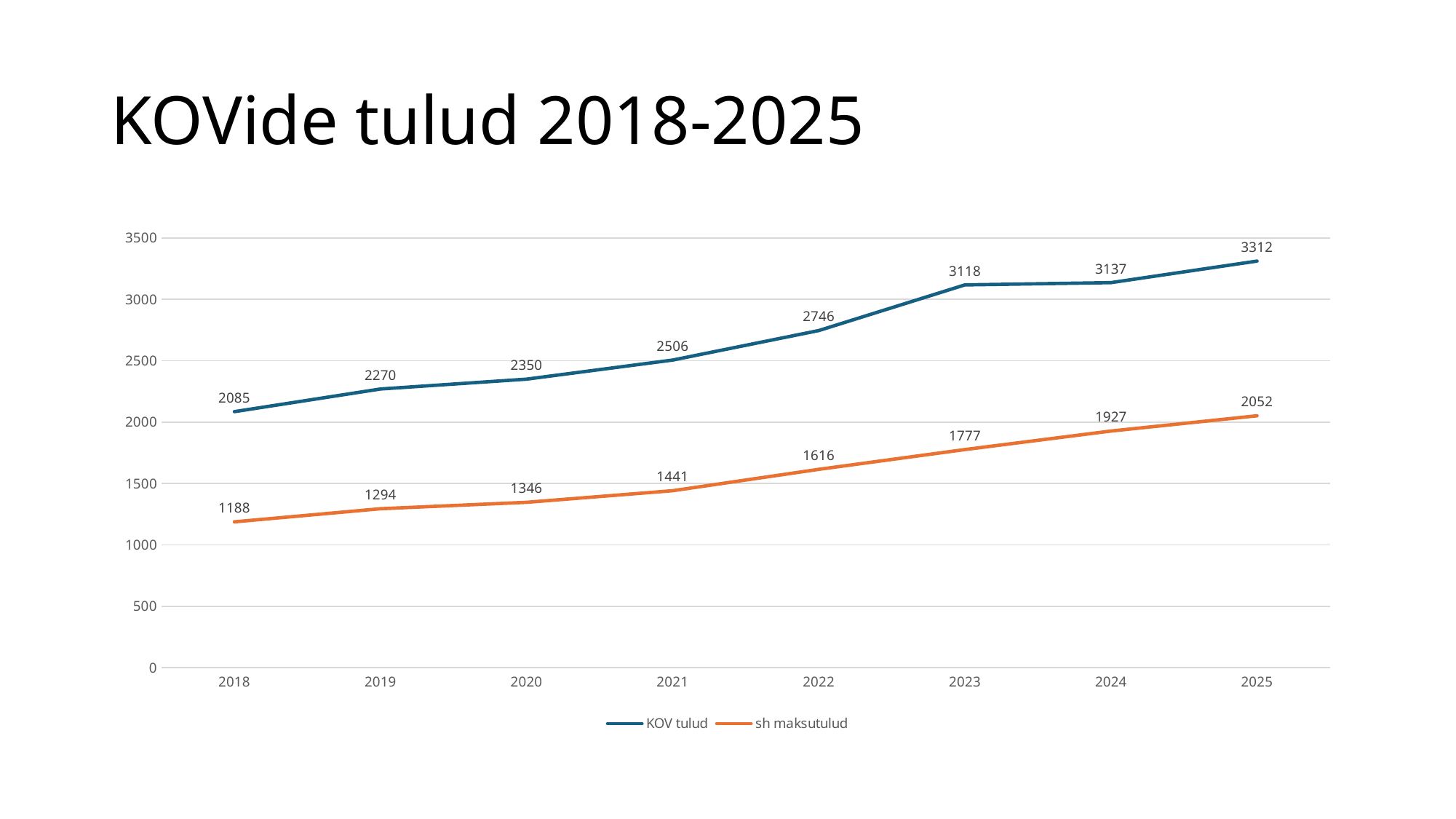
By how much did KOV tulud increase from 2018 to 2019? 185 In which year is sh maksutulud lowest? 2018 Which is larger: sh maksutulud in 2023 or sh maksutulud in 2022? sh maksutulud in 2023 Is the value of KOV tulud in 2022 greater or less than 2500? greater In which year is KOV tulud highest? 2025 What kind of chart is shown on the slide? line chart What is the value of sh maksutulud in 2024? 1927 How many series does the legend list? 2 What is the value of KOV tulud in 2021? 2506 Do the values of sh maksutulud rise or fall from 2018 to 2025? rise How many years are shown on the x axis? 8 What is the difference between KOV tulud and sh maksutulud in 2025? 1260